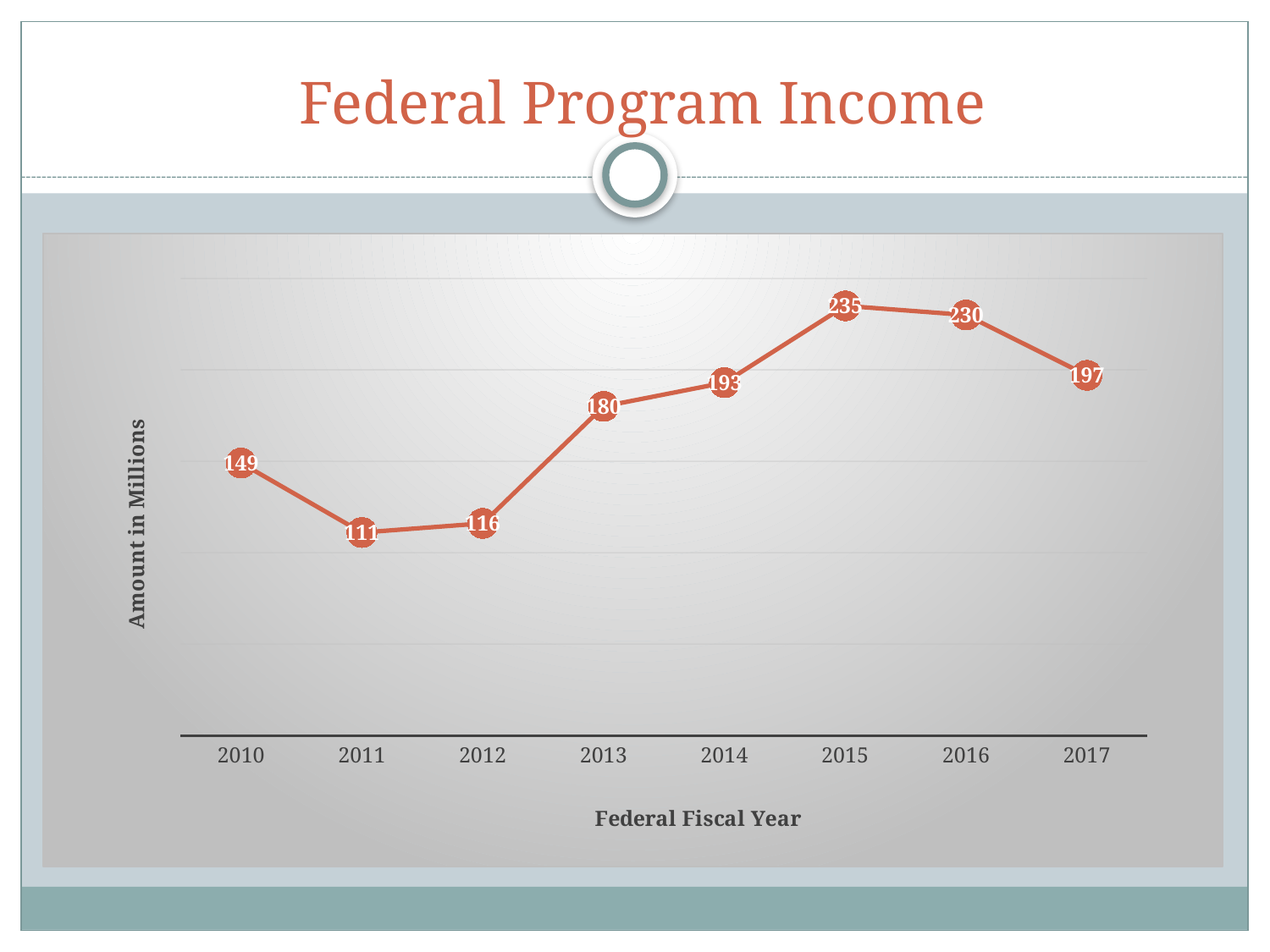
What kind of chart is shown on the slide? Line chart What is the label of the x axis? Federal Fiscal Year How many fiscal years are plotted on the chart? 8 What is the Federal Program Income value for 2013? 180 Which fiscal year has the highest value? 2015 What is the difference between the values for 2015 and 2011? 124 What is the difference between the values for 2014 and 2013? 13 What is the value plotted for 2010? 149 Do the values rise or fall from 2012 to 2015? Rise What is the value plotted for 2017? 197 Which year has the larger value, 2016 or 2017? 2016 Which fiscal year has the lowest value? 2011